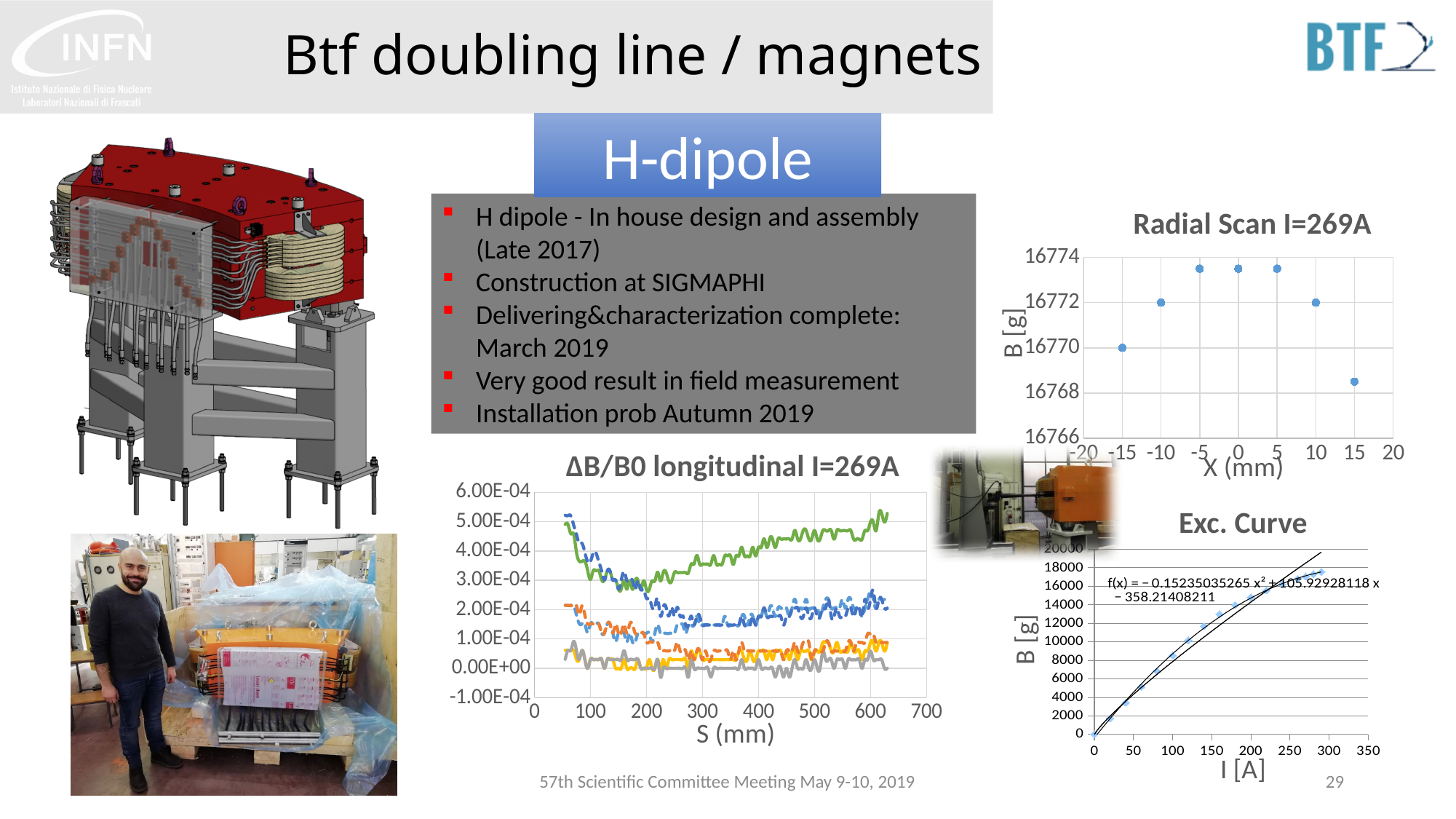
What kind of chart is the ΔB/B0 longitudinal I=269A chart? line chart What is the title of the chart in the upper right of the slide? Radial Scan I=269A In the Radial Scan I=269A chart, what is the value of B [g] at X = 10 mm? 16772 In the Radial Scan I=269A chart, how many data points are plotted? 7 In the Exc. Curve chart, do the plotted B [g] values rise or fall as I [A] increases? rise In the ΔB/B0 longitudinal I=269A chart, is the green line's value at S = 600 mm greater or less than 4.00E-04? greater In the ΔB/B0 longitudinal I=269A chart, what is the label of the x axis? S (mm) In the Radial Scan I=269A chart, what is the value of B [g] at X = -15 mm? 16770 In the Radial Scan I=269A chart, at which X value is B [g] lowest? 15 In the Exc. Curve chart, is the value of the rightmost data point greater or less than 16000? greater In the Radial Scan I=269A chart, is the value at X = 0 mm greater or less than 16772? greater